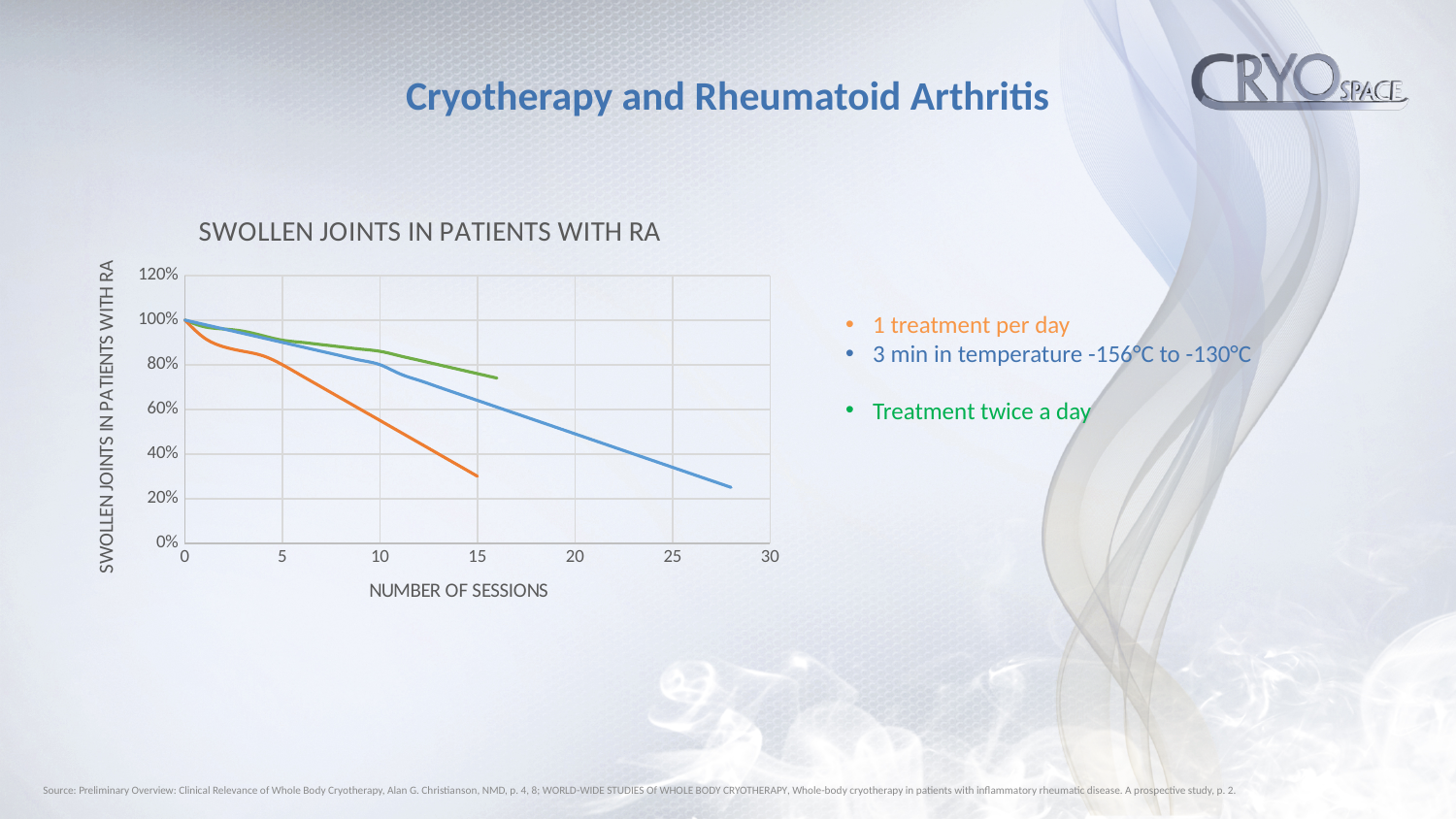
Is the value of the blue line at 25 sessions greater or less than 40%? less How many lines are plotted on the chart? 3 Do the lines rise or fall as the number of sessions increases? fall At 15 sessions, which line shows the lowest value: orange, blue or green? orange What is the title of the chart? SWOLLEN JOINTS IN PATIENTS WITH RA Is the value of the orange line at 5 sessions greater or less than 60%? greater What type of chart is shown on the slide? line chart Is the value of the green line at 15 sessions greater or less than 60%? greater At 15 sessions, which line shows the highest value: orange, blue or green? green What is the label of the x axis of the chart? NUMBER OF SESSIONS What value do all three lines start at when the number of sessions is 0? 100%